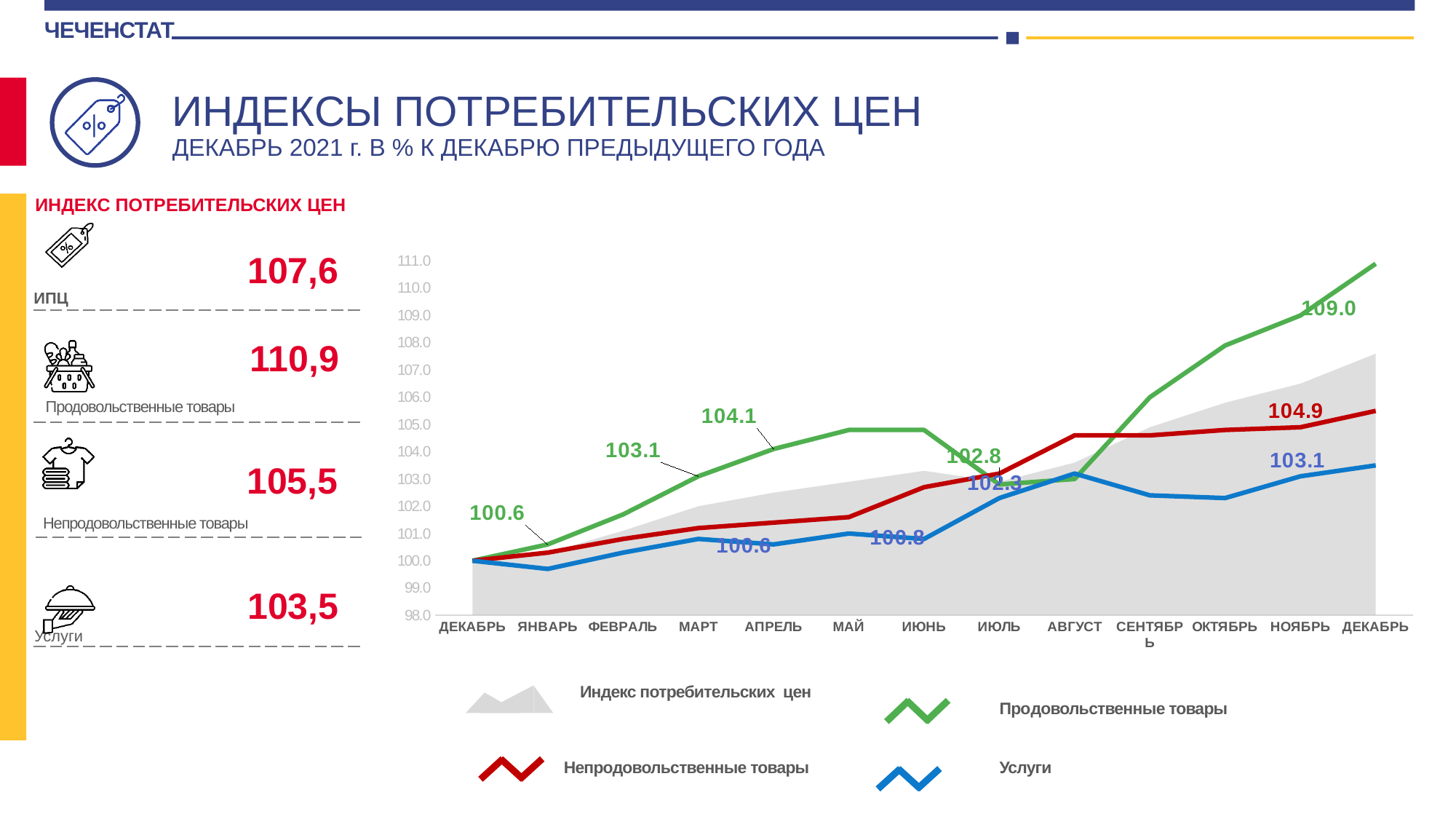
What type of chart is shown on the slide? combination area and line chart What is the value of Продовольственные товары in Апрель? 104.1 How many months are shown along the x axis of the chart? 13 Which series has the highest value in the final Декабрь? Продовольственные товары What is the value of Услуги in Ноябрь? 103.1 What is the value of Продовольственные товары in Январь? 100.6 What is the value of Продовольственные товары in Ноябрь? 109.0 Is the value of Услуги in Октябрь greater or less than 103.0? less What is the difference between Продовольственные товары and Непродовольственные товары in Ноябрь? 4.1 Does the Продовольственные товары line rise or fall overall from the first Декабрь to the last Декабрь? rise How many series does the chart legend list? 4 What is the value of Непродовольственные товары in Ноябрь? 104.9